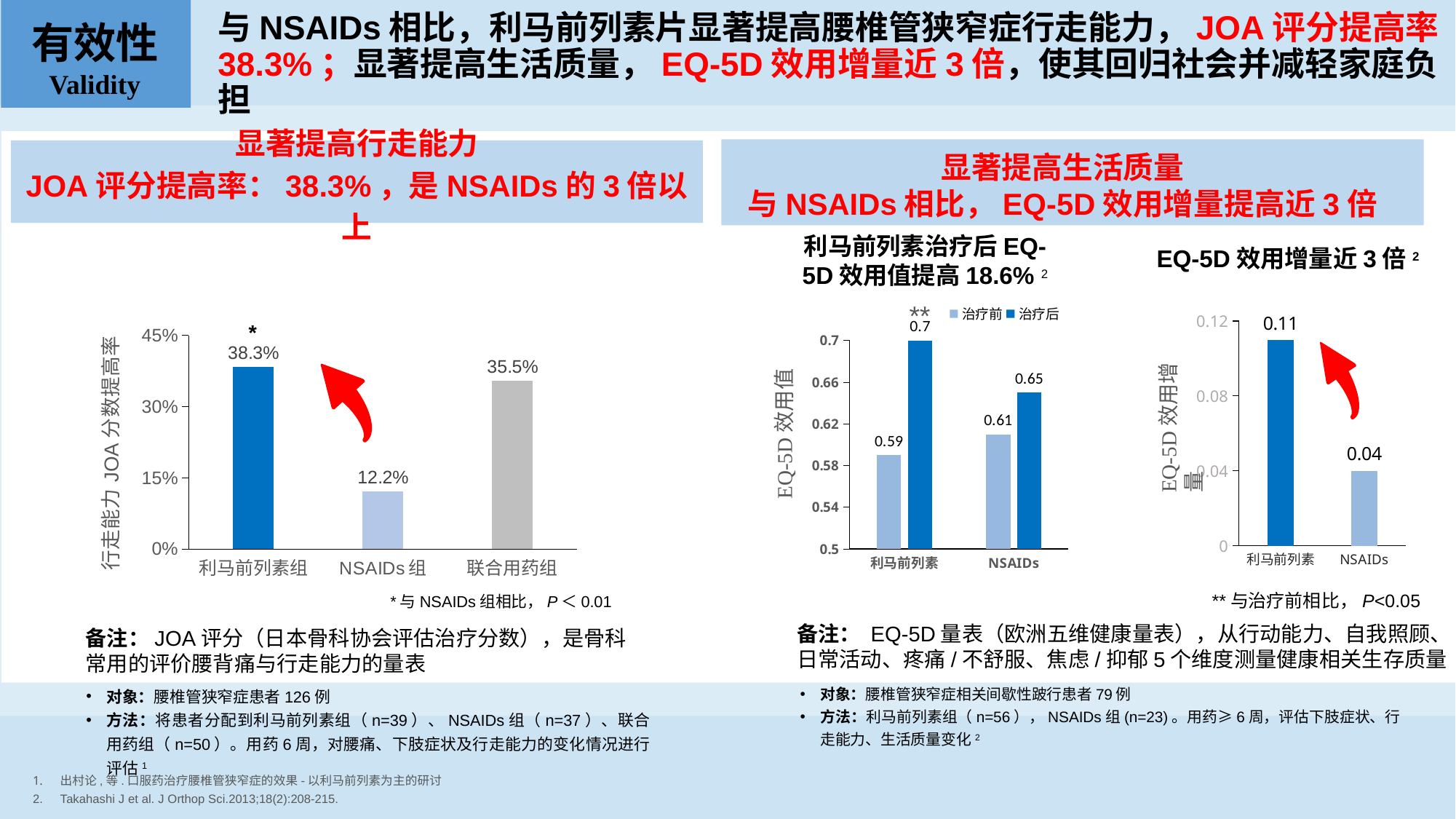
In the left chart (行走能力 JOA 分数提高率), which group has the lowest value? NSAIDs 组 In the right chart (EQ-5D 效用增量), what is the value for NSAIDs? 0.04 In the middle chart (EQ-5D 效用值), what is the 治疗前 value for NSAIDs? 0.61 What type of chart is the right chart (EQ-5D 效用增量)? bar chart In the middle chart (EQ-5D 效用值), which is larger: the 治疗后 value for 利马前列素 or the 治疗后 value for NSAIDs? 利马前列素 In the middle chart (EQ-5D 效用值), what is the 治疗后 value for 利马前列素? 0.7 In the left chart (行走能力 JOA 分数提高率), what is the value for 利马前列素组? 38.3% In the left chart (行走能力 JOA 分数提高率), what is the value for NSAIDs 组? 12.2% In the left chart (行走能力 JOA 分数提高率), what is the difference between 利马前列素组 and NSAIDs 组? 26.1% How many series does the legend of the middle chart (EQ-5D 效用值) list? 2 How many categories are shown in the left chart (行走能力 JOA 分数提高率)? 3 In the right chart (EQ-5D 效用增量), what is the difference between 利马前列素 and NSAIDs? 0.07